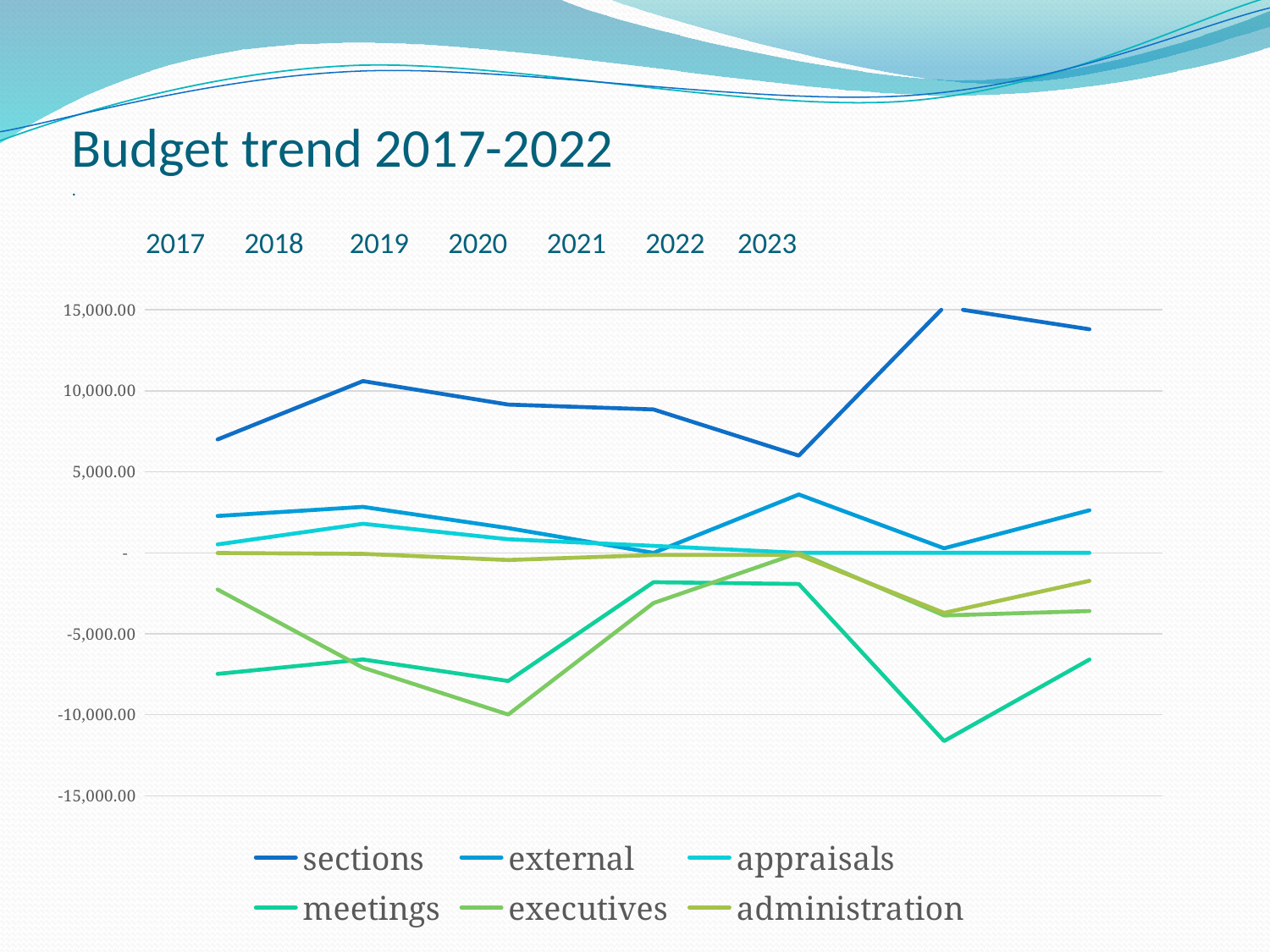
Which series reaches the lowest value on the chart? meetings How many data points does each line have? 7 What kind of chart is shown on the slide? line chart Which series is plotted with the darkest blue line? sections At the first point (2017), which is larger: sections or external? sections What is the title of the slide? Budget trend 2017-2022 How many series does the legend list? 6 Is the value for sections at the last point (2023) greater or less than 10,000.00? greater Is the value for meetings at the first point (2017) greater or less than -5,000.00? less Which series reaches the highest value on the chart? sections Is the value for meetings at the sixth point (2022) greater or less than -10,000.00? less Does the sections line rise or fall from the first point (2017) to the third point (2019)? rise